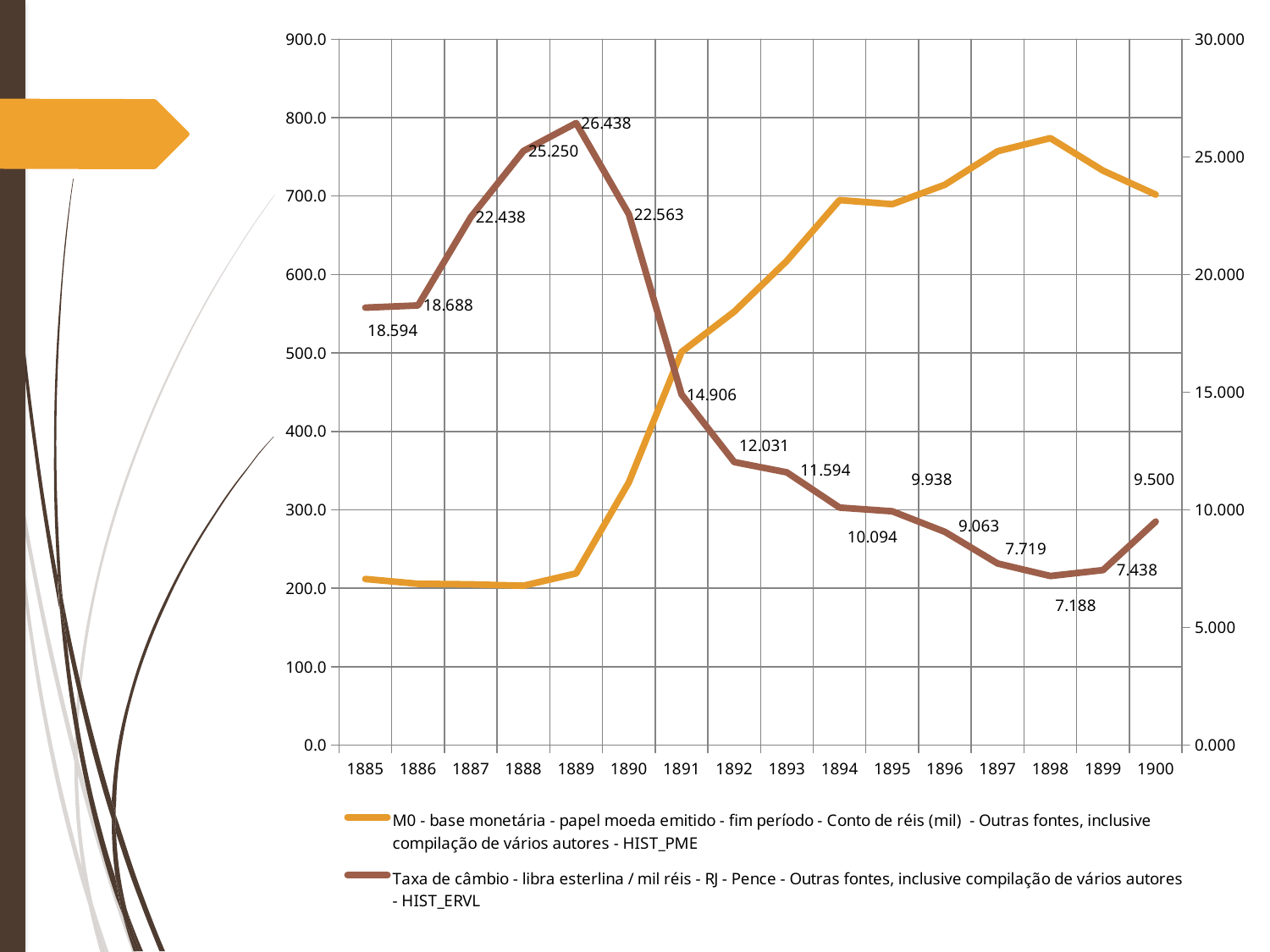
How many series does the legend list? 2 What is the value of the Taxa de câmbio series in 1885? 18.594 What is the value of the Taxa de câmbio series in 1889? 26.438 In which year does the Taxa de câmbio series reach its lowest value? 1898 What is the value of the Taxa de câmbio series in 1898? 7.188 Which year has a higher Taxa de câmbio value, 1892 or 1896? 1892 In which year does the Taxa de câmbio series reach its highest value? 1889 How many years are shown on the x axis? 16 What kind of chart is shown on the slide? Line chart What is the difference between the Taxa de câmbio values in 1889 and 1885? 7.844 Is the value of the M0 series in 1898 greater or less than 700.0? greater Is the value of the M0 series in 1885 greater or less than 300.0? less